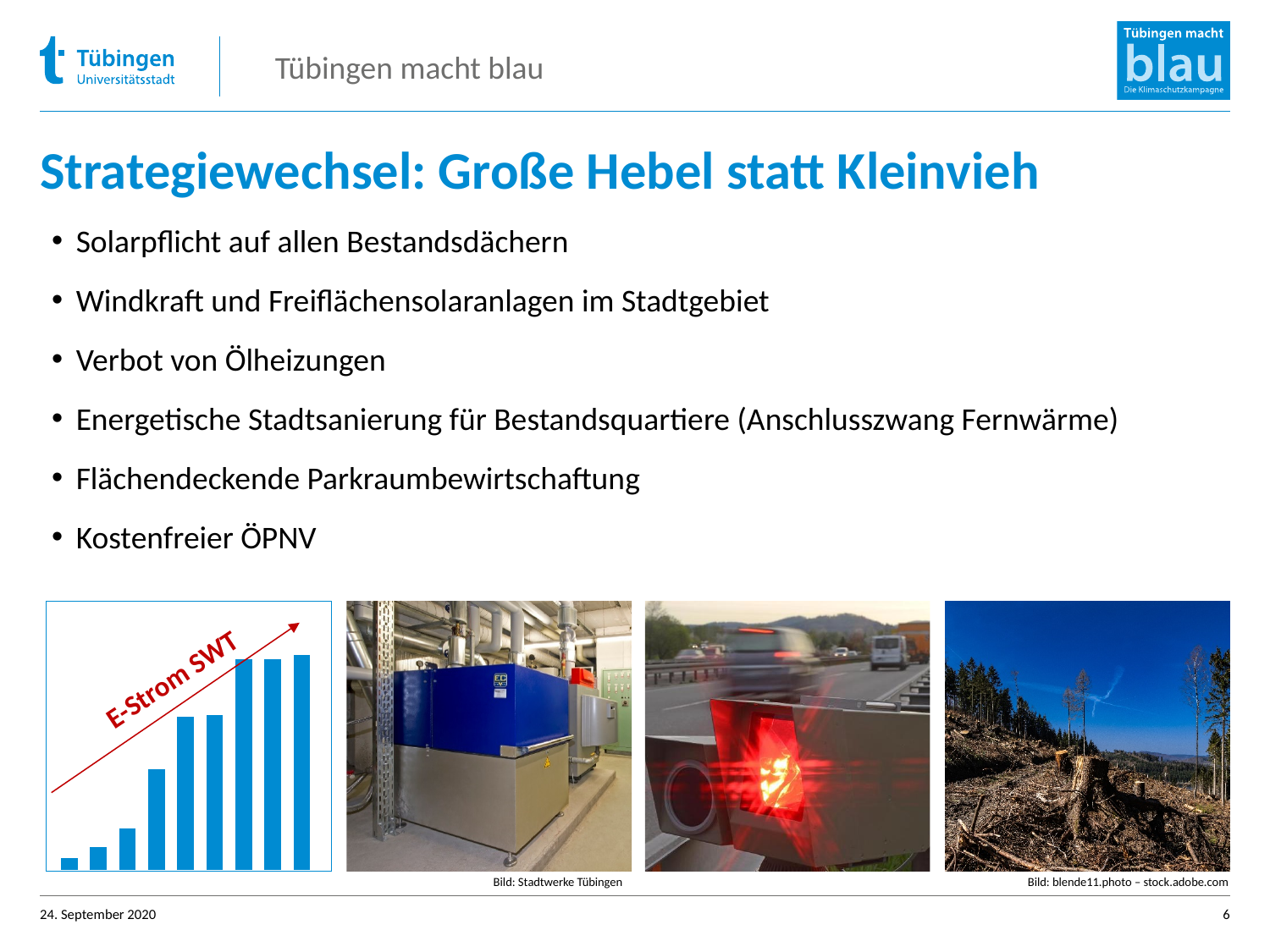
What kind of chart is shown at the bottom left of the slide? bar chart What text label is written diagonally on the chart at the bottom left of the slide? E-Strom SWT In the chart at the bottom left of the slide, which bar is the shortest? the leftmost bar What colour is the arrow drawn over the bars in the chart at the bottom left of the slide? red In the chart at the bottom left of the slide, do the bar values rise or fall from left to right? rise In the chart at the bottom left of the slide, is the leftmost bar or the rightmost bar taller? the rightmost bar How many bars does the chart at the bottom left of the slide contain? 9